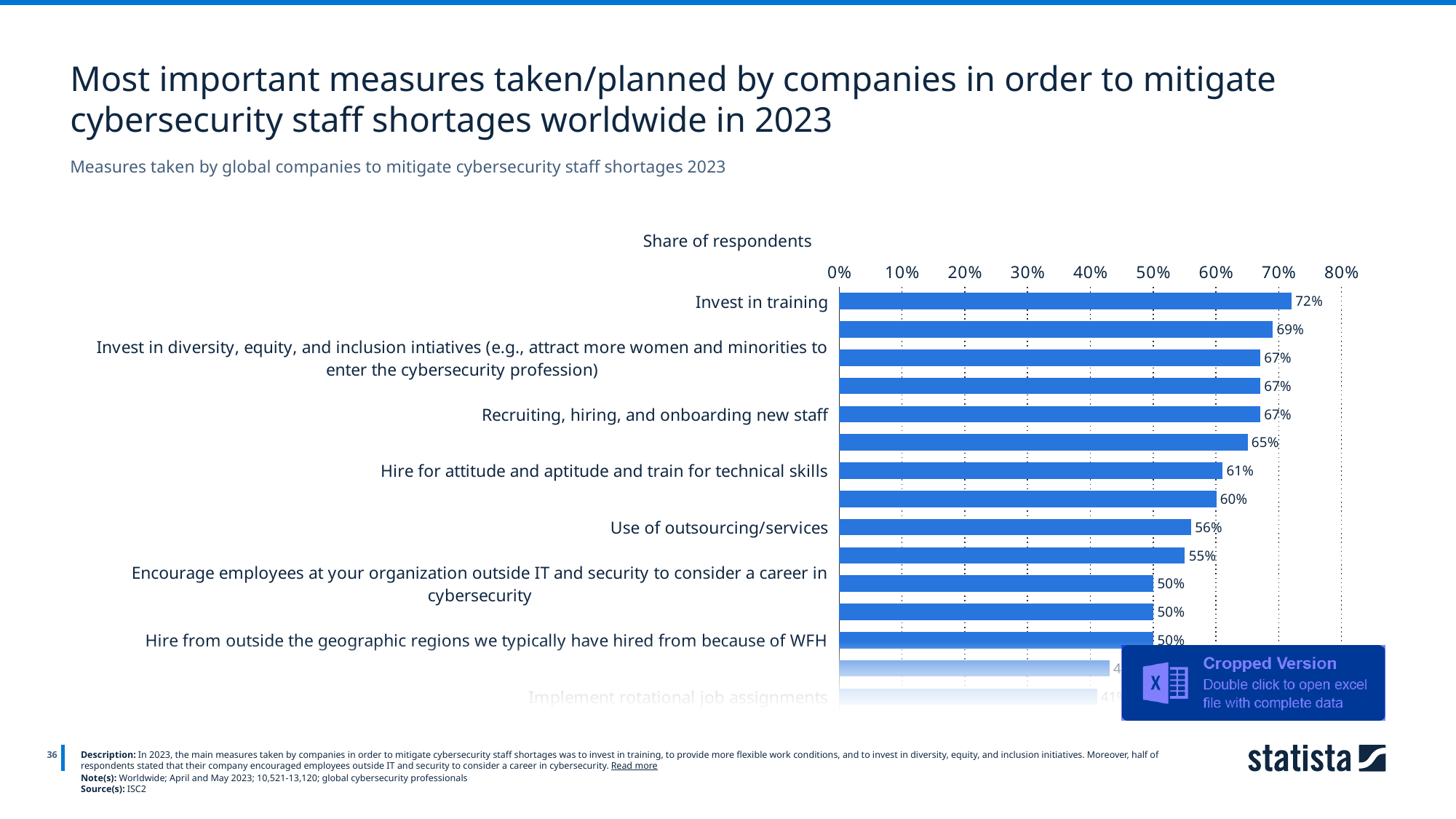
What share of respondents cited 'Use of outsourcing/services'? 56% What is the value for 'Recruiting, hiring, and onboarding new staff'? 67% What is the value for 'Hire from outside the geographic regions we typically have hired from because of WFH'? 50% Is the value for 'Invest in diversity, equity, and inclusion initiatives' greater or less than 60%? greater Which measure has the highest share of respondents? Invest in training What is the difference between 'Hire for attitude and aptitude and train for technical skills' and 'Encourage employees at your organization outside IT and security to consider a career in cybersecurity'? 11% What is the value for 'Hire for attitude and aptitude and train for technical skills'? 61% What is the label shown above the chart's x axis? Share of respondents What share of respondents cited 'Invest in training' as a measure? 72% What kind of chart is shown on the slide? bar chart Which is larger: the value for 'Recruiting, hiring, and onboarding new staff' or the value for 'Hire for attitude and aptitude and train for technical skills'? Recruiting, hiring, and onboarding new staff What is the difference between 'Invest in training' and 'Use of outsourcing/services'? 16%